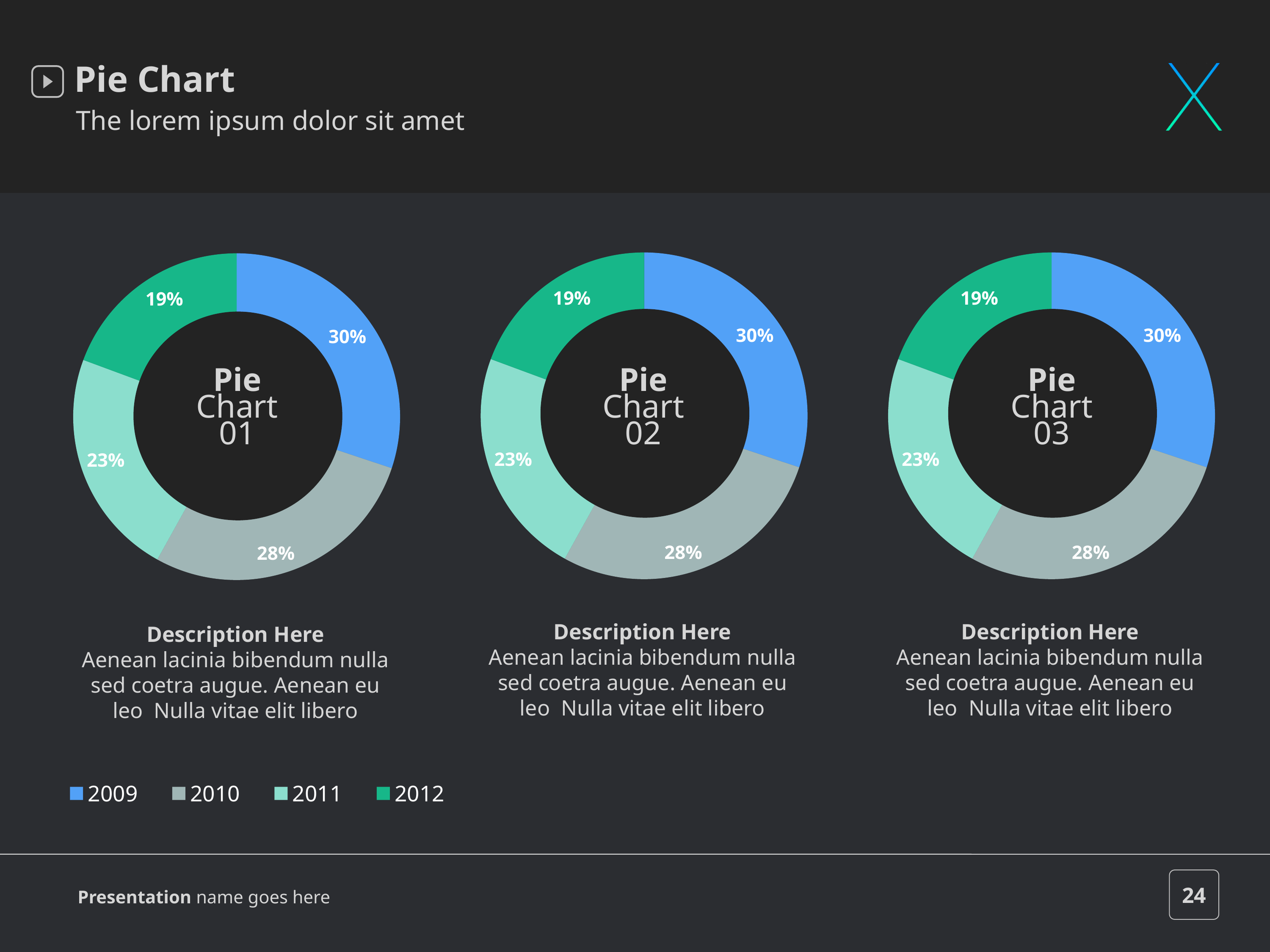
In Pie Chart 02, what is the value for 2010? 28% How many entries does the legend list? 4 In Pie Chart 02, which is larger, the share for 2010 or the share for 2011? 2010 In Pie Chart 02, which year has the largest share? 2009 Which colour represents 2011 in the legend? Light green In Pie Chart 01, what is the value for 2012? 19% What kind of chart is Pie Chart 01? Pie chart In Pie Chart 01, what is the value for 2009? 30% In Pie Chart 01, what is the difference between the 2009 and 2012 shares? 11% How many slices does Pie Chart 03 have? 4 In Pie Chart 03, what is the value for 2011? 23% In Pie Chart 03, which year has the smallest share? 2012